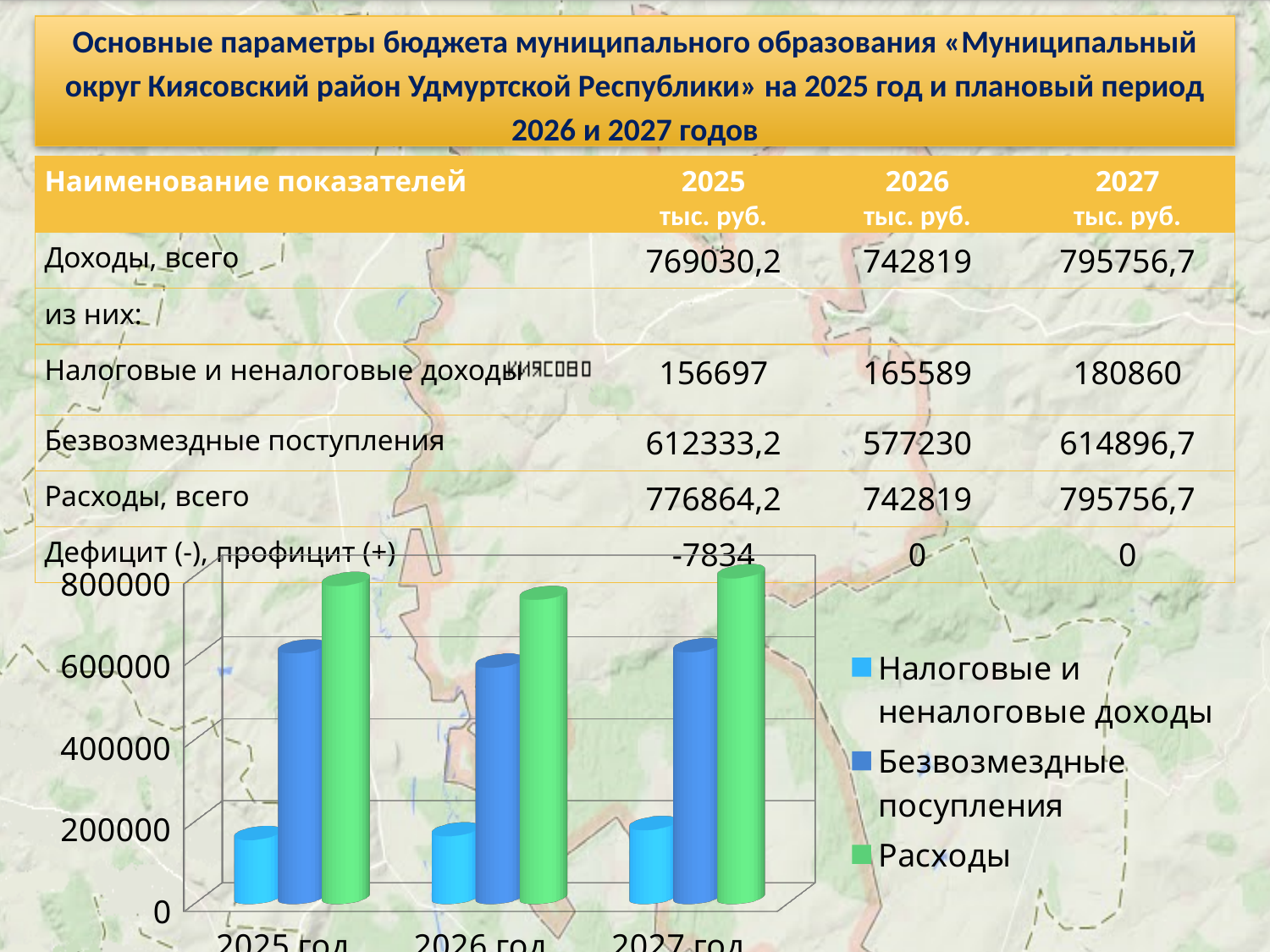
What is the highest value shown on the chart's vertical axis? 800000 Is the value for Расходы in 2026 год greater or less than 600000? greater Which series is shown in green in the chart? Расходы Is the value for Безвозмездные посупления in 2027 год greater or less than 400000? greater In 2026 год, which is larger: Расходы or Налоговые и неналоговые доходы? Расходы How many series does the chart's legend list? 3 Is the value for Налоговые и неналоговые доходы in 2025 год greater or less than 200000? less What kind of chart is shown at the bottom of the slide? bar chart For Безвозмездные посупления, which year has the larger value: 2026 год or 2027 год? 2027 год How many year categories are shown on the chart's x axis? 3